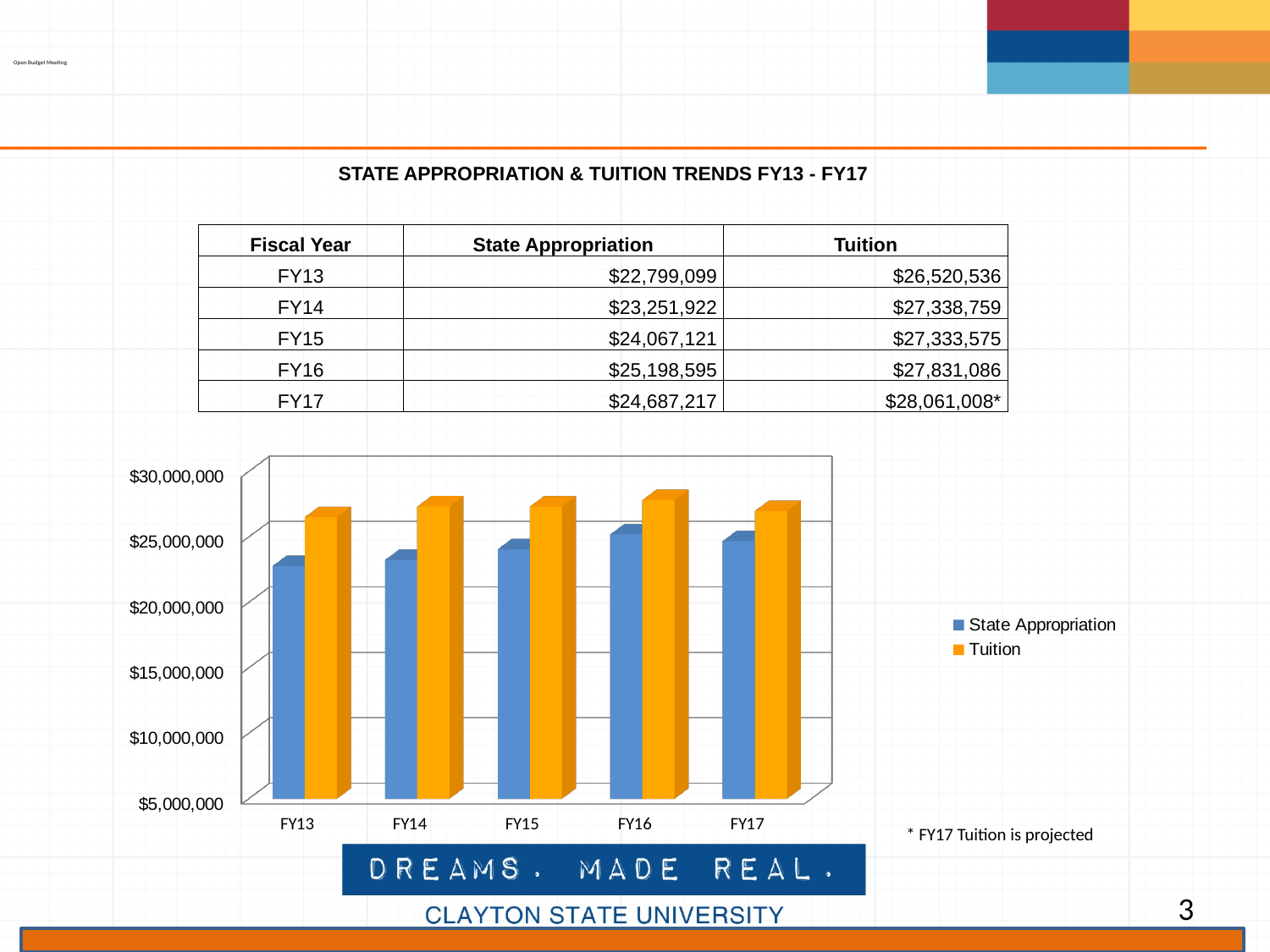
Which series is shown in orange in the chart? Tuition What type of chart is shown on the slide? bar chart Which fiscal year has the lowest Tuition? FY13 What is the difference between Tuition and State Appropriation in FY13? $3,721,437 Does Tuition rise or fall from FY13 to FY17? rises How many series does the chart legend list? 2 What is the State Appropriation value for FY13? $22,799,099 Is the State Appropriation value for FY13 greater or less than $25,000,000? less Which is larger in FY17, State Appropriation or Tuition? Tuition Which fiscal year has the highest State Appropriation? FY16 How many fiscal years are plotted on the x axis of the chart? 5 What is the Tuition value for FY16? $27,831,086